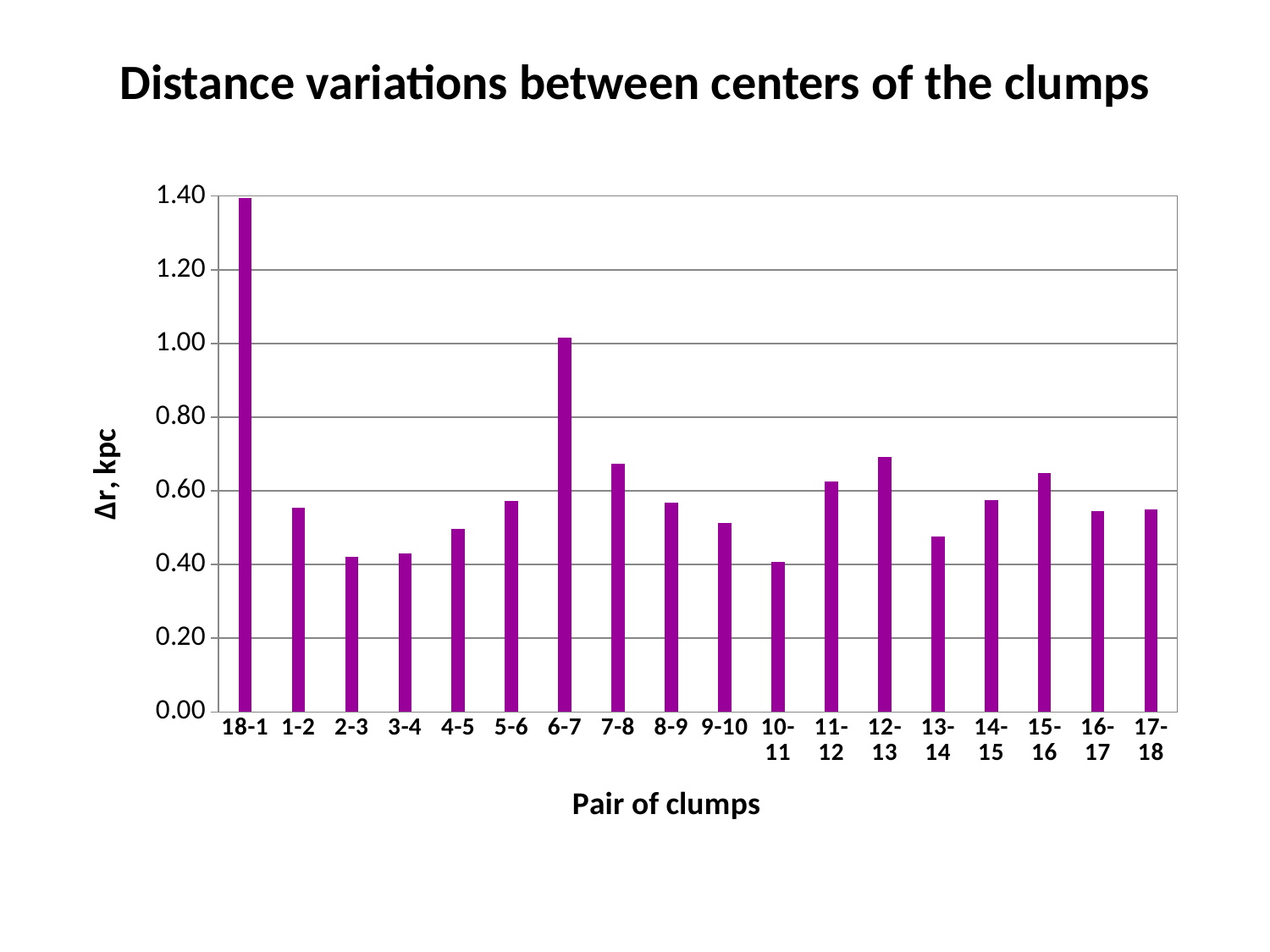
Which is larger, the value for pair 15-16 or the value for pair 13-14? 15-16 Which is larger, the value for pair 6-7 or the value for pair 7-8? 6-7 Is the value for pair 18-1 greater or less than 1.20? greater Is the value for pair 6-7 greater or less than 0.80? greater Is the value for pair 3-4 greater or less than 0.60? less What is the title of the x axis? Pair of clumps What kind of chart is shown on the slide? bar chart How many pairs of clumps are plotted on the x axis? 18 What is the title of the y axis? Δr, kpc Which pair of clumps has the highest distance variation? 18-1